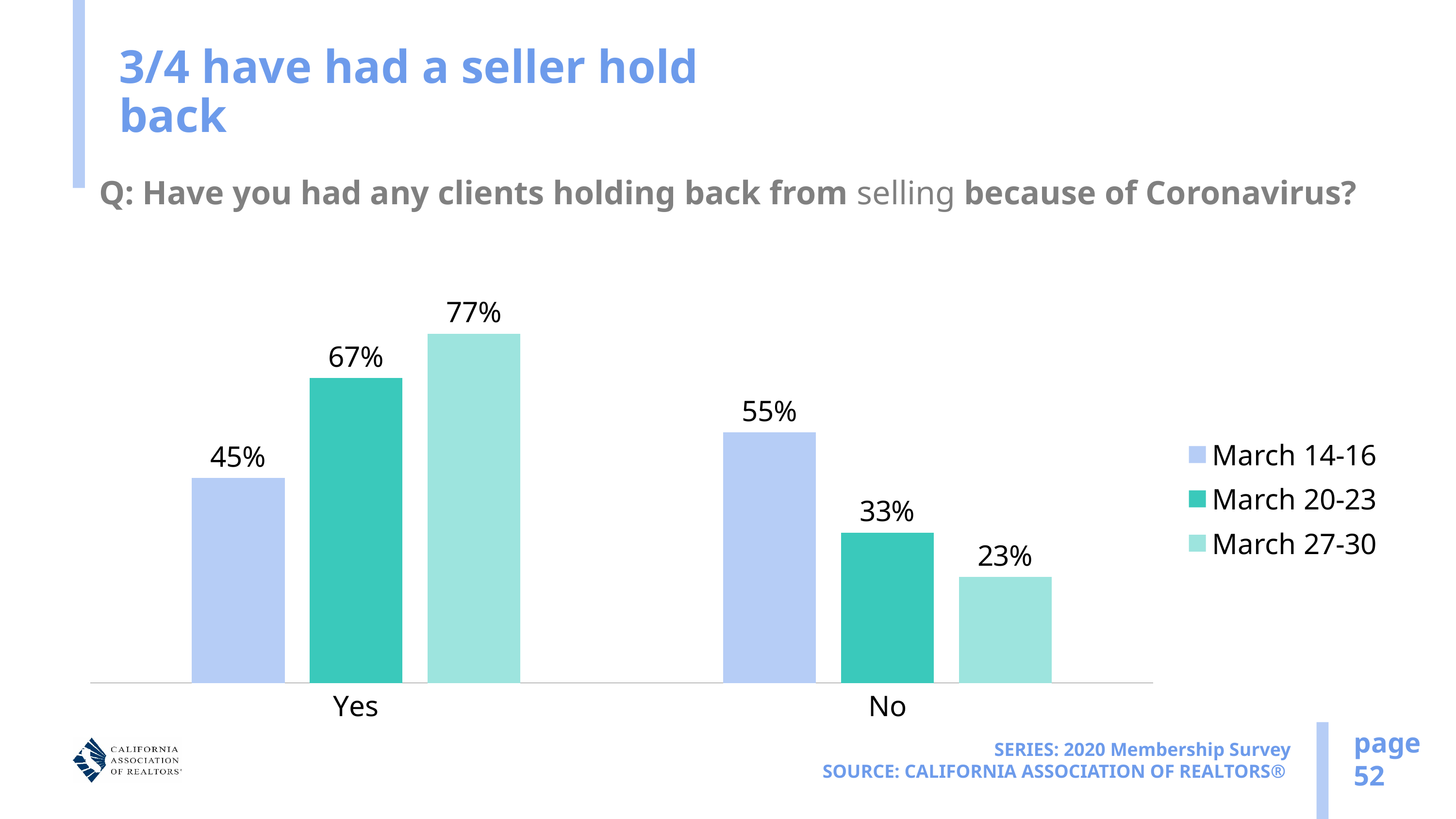
Across the three survey periods, does the Yes percentage rise or fall over time? Rise What kind of chart is shown on the slide? Bar chart How many series does the legend list? 3 Which is larger: the Yes percentage for March 14-16 or the No percentage for March 14-16? No percentage for March 14-16 Which survey period has the lowest No percentage? March 27-30 Which survey period has the highest Yes percentage? March 27-30 What percentage answered Yes in the March 27-30 survey? 77% What percentage answered No in the March 14-16 survey? 55% What percentage answered Yes in the March 20-23 survey? 67% What is the difference between the No percentages for March 14-16 and March 20-23? 22% How many categories are shown on the x axis? 2 What is the difference between the Yes percentages for March 27-30 and March 14-16? 32%